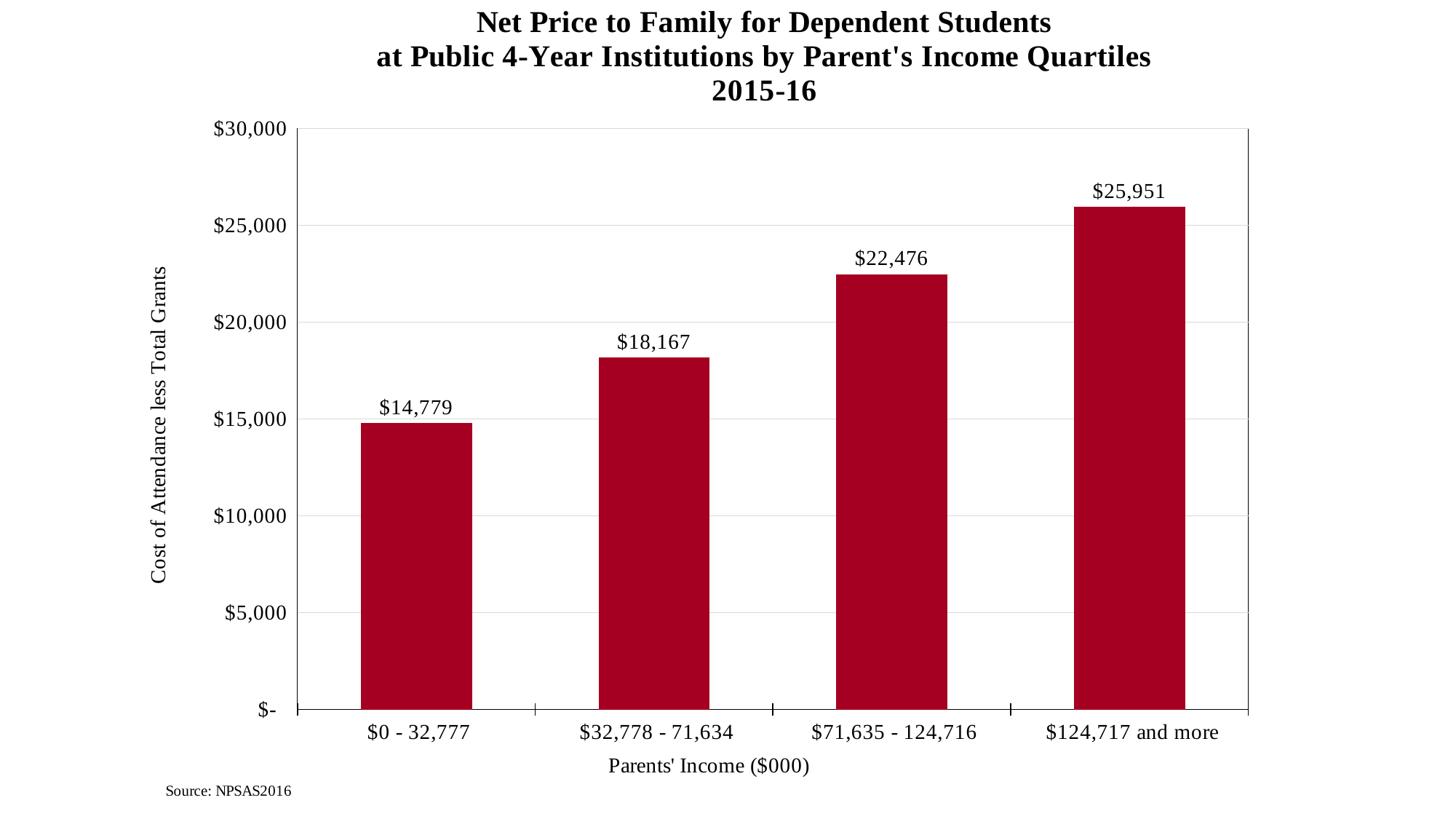
What is the net price to family for the $0 - 32,777 parents' income quartile? $14,779 Which parents' income quartile has the lowest net price to family? $0 - 32,777 What is the difference in net price between the $124,717 and more quartile and the $0 - 32,777 quartile? $11,172 Do the net price values rise or fall as parents' income increases along the x axis? Rise What is the difference in net price between the $71,635 - 124,716 quartile and the $32,778 - 71,634 quartile? $4,309 What is the net price to family for the $32,778 - 71,634 parents' income quartile? $18,167 Which parents' income quartile has the highest net price to family? $124,717 and more What is the net price to family for the $71,635 - 124,716 parents' income quartile? $22,476 How many parents' income quartiles are shown on the chart? 4 Which has a higher net price to family: the $32,778 - 71,634 quartile or the $71,635 - 124,716 quartile? $71,635 - 124,716 What kind of chart is shown on the slide? Bar chart What is the net price to family for the $124,717 and more parents' income quartile? $25,951